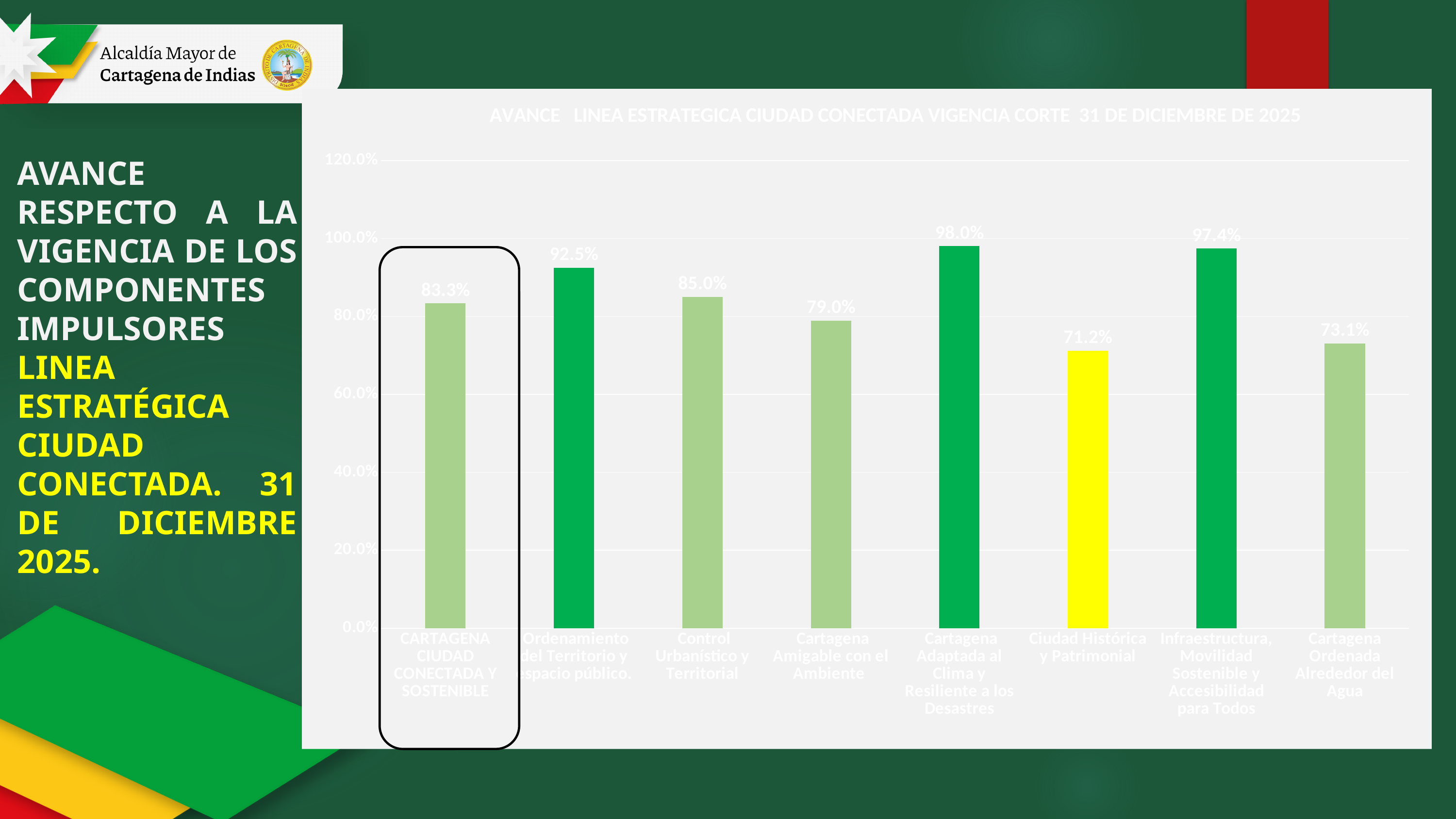
Is the value for Infraestructura, Movilidad Sostenible y Accesibilidad para Todos greater or less than 80.0%? greater How many bars (categories) does the chart show? 8 What is the value for Ciudad Histórica y Patrimonial? 71.2% What type of chart is shown on the slide? Bar chart What is the value for CARTAGENA CIUDAD CONECTADA Y SOSTENIBLE? 83.3% Which category has the highest value? Cartagena Adaptada al Clima y Resiliente a los Desastres What is the value for Cartagena Ordenada Alrededor del Agua? 73.1% Which bar is shown in yellow? Ciudad Histórica y Patrimonial Which is larger, the value for Control Urbanístico y Territorial or the value for Cartagena Amigable con el Ambiente? Control Urbanístico y Territorial What is the difference between the values for Cartagena Adaptada al Clima y Resiliente a los Desastres and Ciudad Histórica y Patrimonial? 26.8% What is the value for Ordenamiento del Territorio y espacio público? 92.5% Which category has the lowest value? Ciudad Histórica y Patrimonial